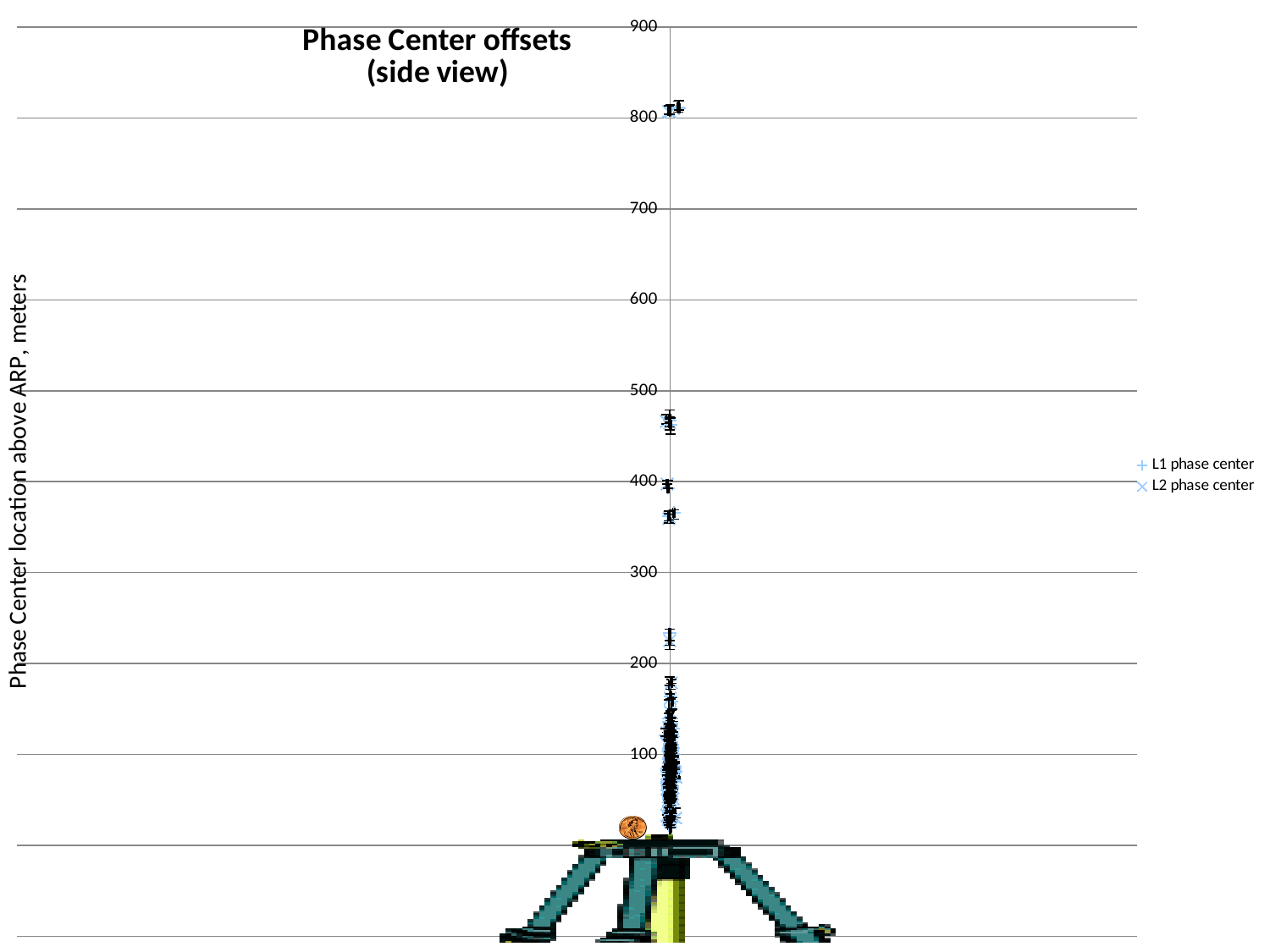
Is the lowest plotted phase center value greater or less than 100? less Is the isolated cluster of points between the 200 and 300 gridlines greater or less than 300? less What is the highest value labelled on the vertical axis? 900 Is the cluster of points just below the 500 gridline greater or less than 400? greater What kind of chart is shown on the slide? scatter chart How many series does the legend list? 2 What is the title of the chart? Phase Center offsets (side view) What is the label of the vertical axis? Phase Center location above ARP, meters